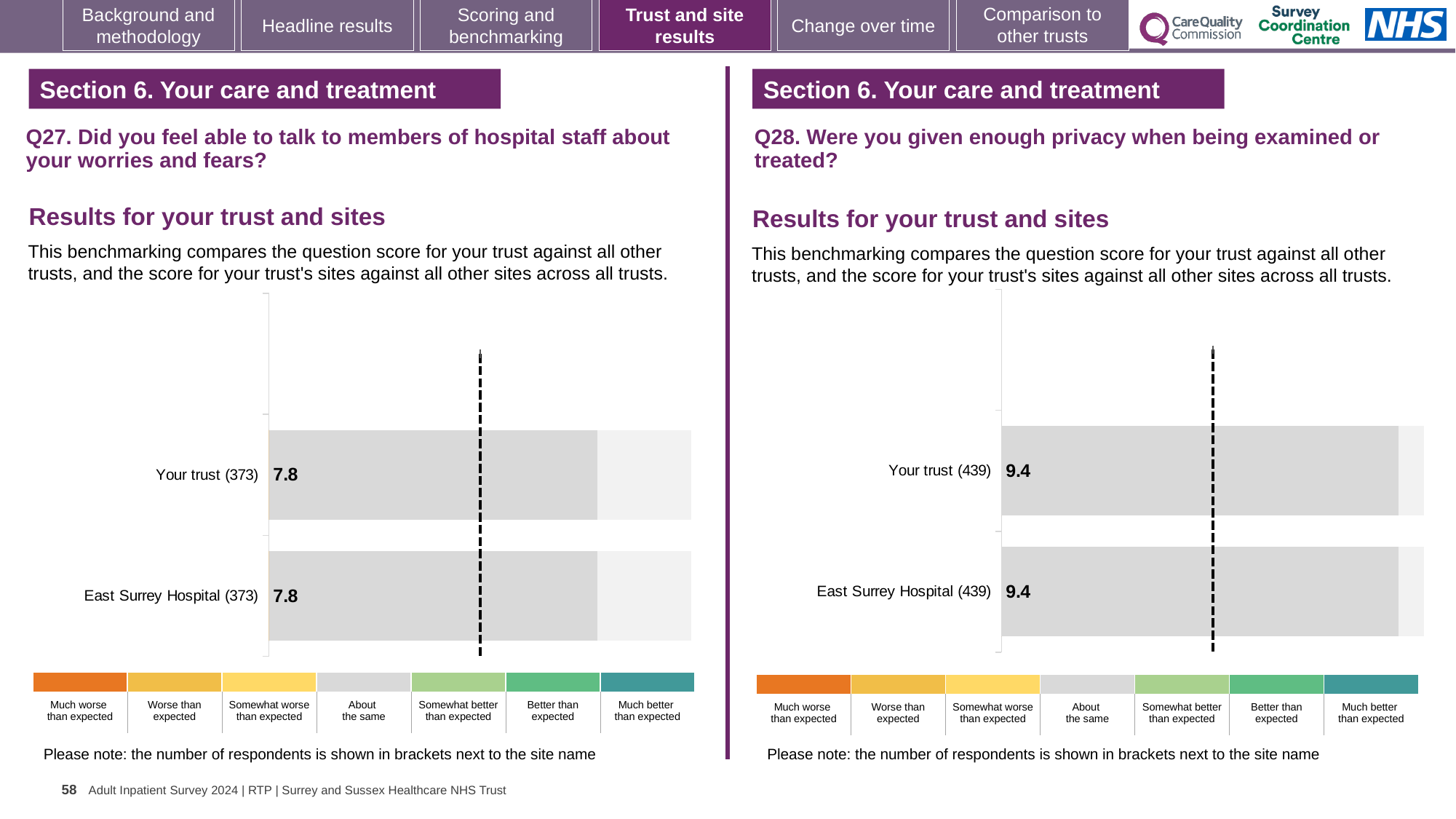
In the Q27 chart on the left, what is the score for East Surrey Hospital? 7.8 What kind of chart is used for the Q27 results on the left? Bar chart In the Q28 chart on the right, what is the score for East Surrey Hospital? 9.4 In the Q28 chart on the right, what is the difference between the score for Your trust and the score for East Surrey Hospital? 0 Is the score for Your trust in the Q28 chart on the right larger or smaller than the score for Your trust in the Q27 chart on the left? Larger In the Q27 chart on the left, what is the score for Your trust? 7.8 How many bars are plotted in the Q28 chart on the right? 2 In the Q27 chart on the left, how many respondents are shown in brackets next to Your trust? 373 In the Q28 chart on the right, what is the score for Your trust? 9.4 How many bars are plotted in the Q27 chart on the left? 2 In the Q28 chart on the right, how many respondents are shown in brackets next to East Surrey Hospital? 439 In the Q27 chart on the left, what is the difference between the score for Your trust and the score for East Surrey Hospital? 0